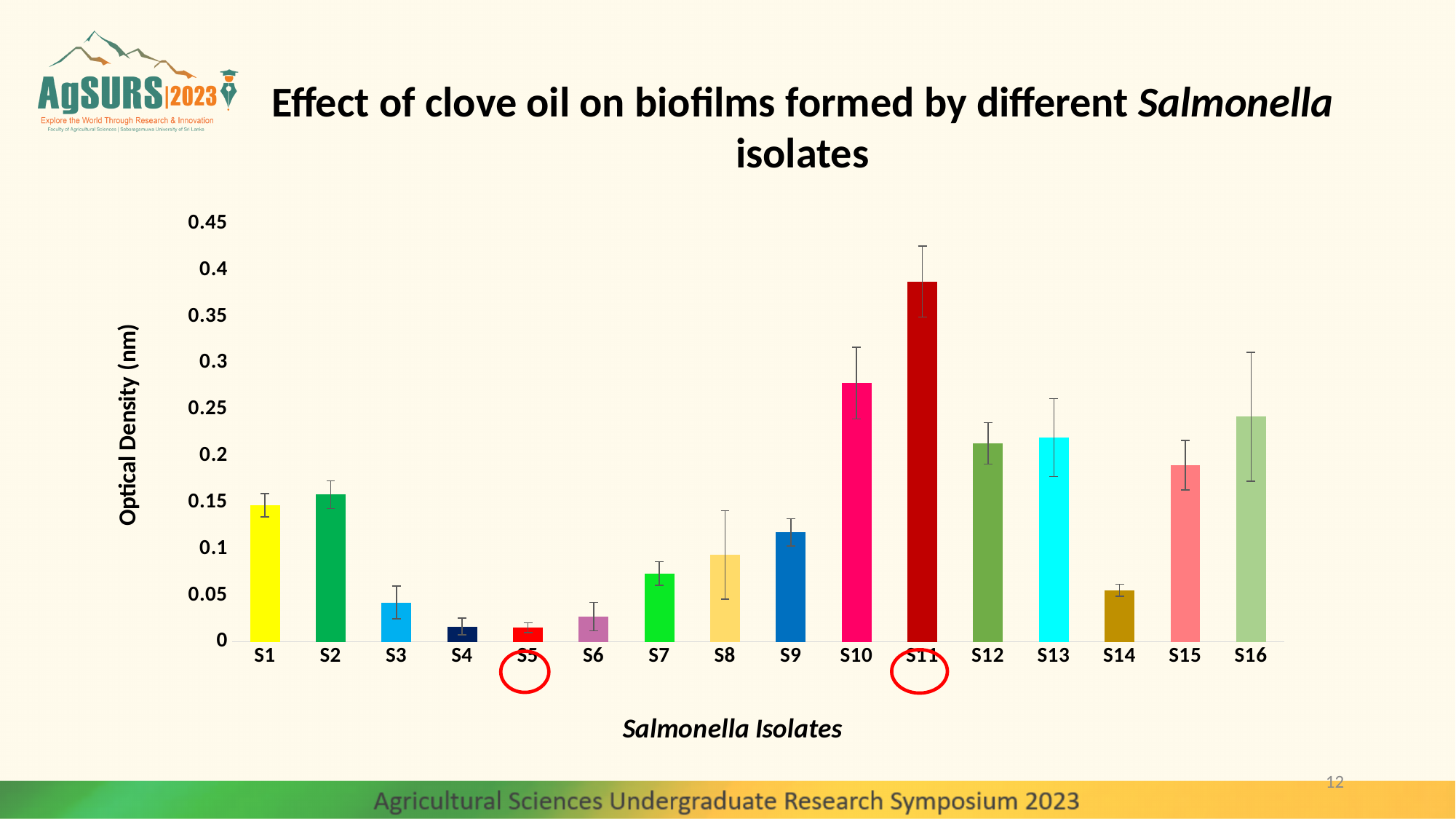
What kind of chart is shown on the slide? bar chart How many Salmonella isolates are plotted on the x axis? 16 Which has the higher optical density, S8 or S9? S9 Is the value for S9 greater or less than 0.1? greater Is the value for S7 greater or less than 0.1? less Which two isolate labels are circled in red on the x axis? S5 and S11 Which has the higher optical density, S10 or S16? S10 What is the label of the y axis? Optical Density (nm) Is the value for S3 greater or less than 0.05? less Which isolate has the highest optical density? S11